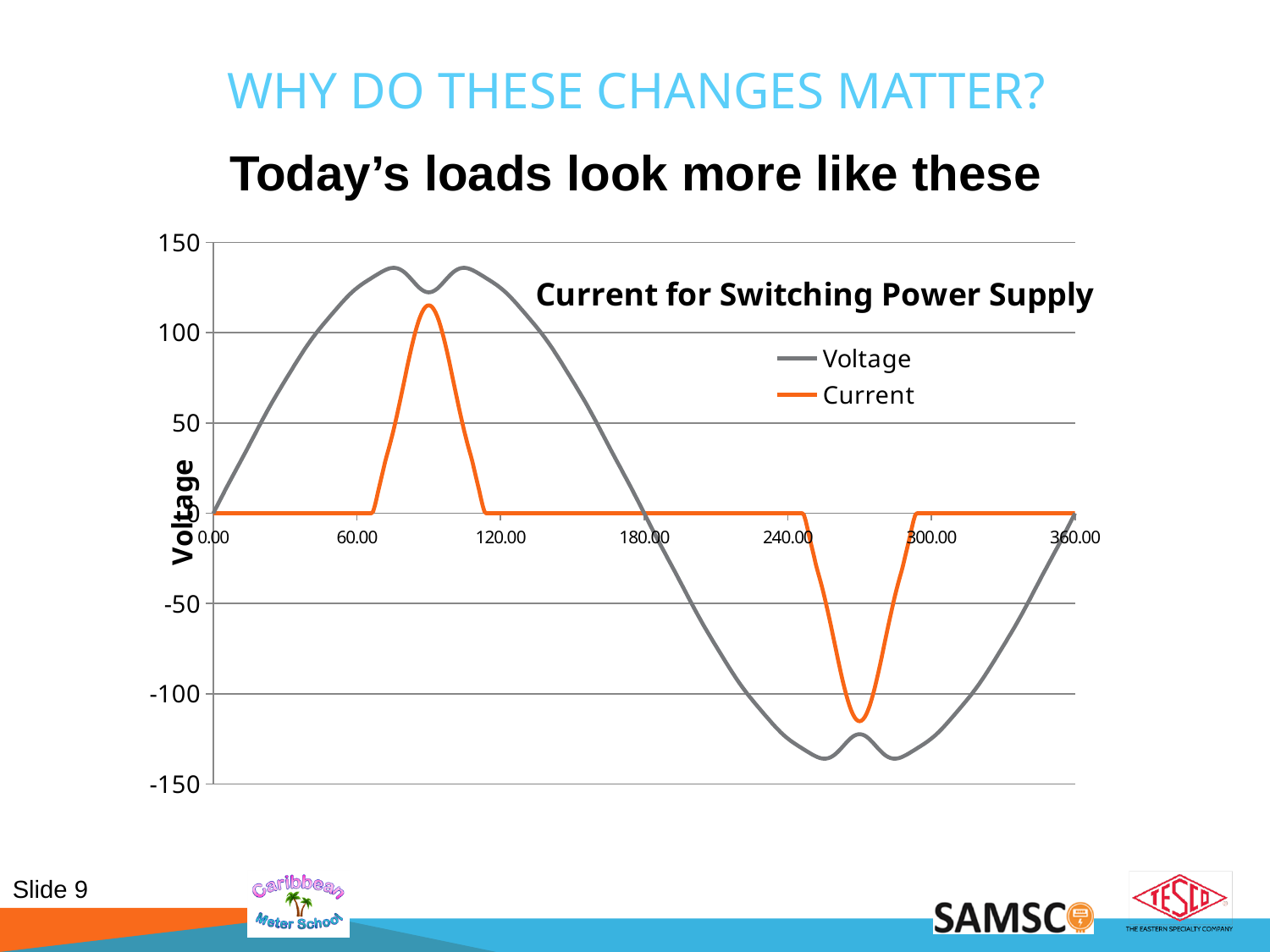
What is the value of the Current series at x = 180.00? 0 Is the lowest value of the Voltage series greater or less than -100? less Is the peak value of the Current series greater or less than 100? greater Does the Voltage series rise or fall between x = 0.00 and x = 60.00? rise Which series reaches the higher peak value, Voltage or Current? Voltage How many series does the legend list? 2 Is the lowest value of the Current series greater or less than -100? less What is the title of the chart? Current for Switching Power Supply What kind of chart is shown on the slide? line chart At x = 60.00, which series has the larger value, Voltage or Current? Voltage Which series is drawn in orange? Current